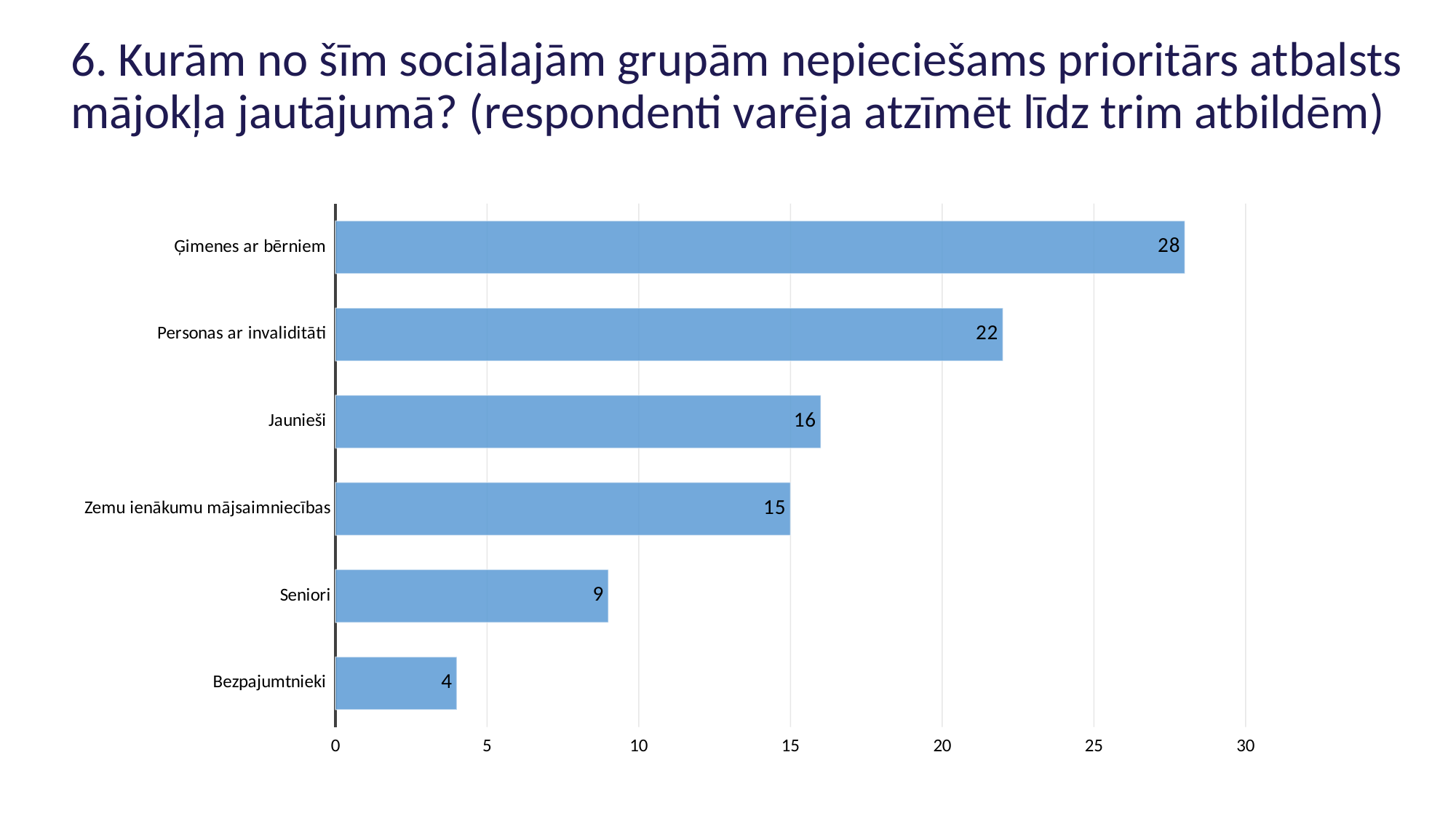
What is the difference between the values for Ģimenes ar bērniem and Personas ar invaliditāti? 6 Which category has the lowest value? Bezpajumtnieki What kind of chart is shown on the slide? bar chart Which category has the highest value? Ģimenes ar bērniem How many categories are shown in the chart? 6 Which is larger, the value for Seniori or the value for Bezpajumtnieki? Seniori What is the value for Personas ar invaliditāti? 22 Is the value for Personas ar invaliditāti greater or less than 20? greater What is the value for Bezpajumtnieki? 4 What is the difference between the values for Jaunieši and Zemu ienākumu mājsaimniecības? 1 What is the value for Ģimenes ar bērniem? 28 What is the value for Seniori? 9